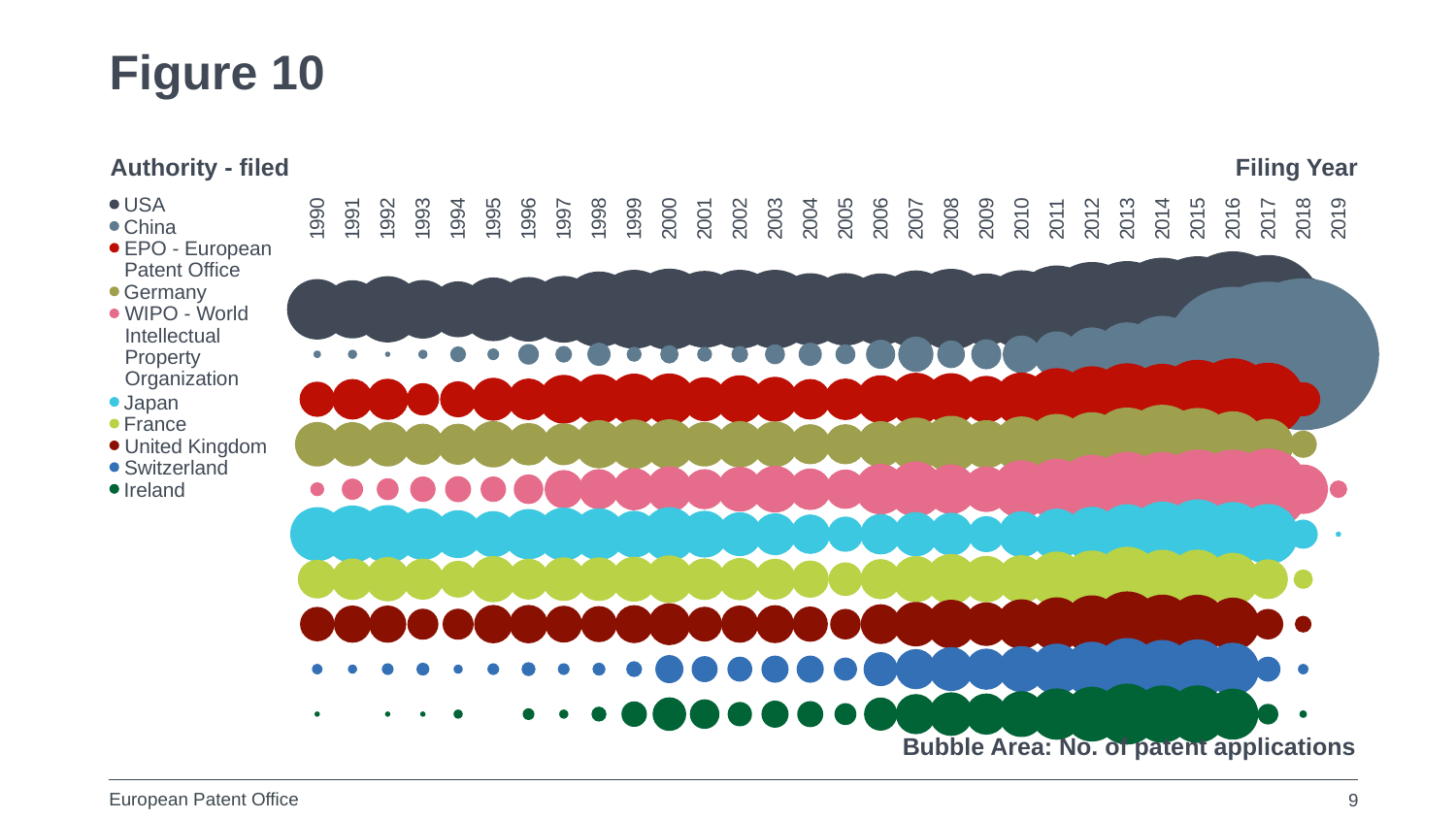
How many authorities does the legend list? 10 Is the China bubble larger in 1990 or in 2019? 2019 What is the label of the x axis? Filing Year Which authority has the largest bubble in 2019? China Does the bubble size for China rise or fall from 1990 to 2019? Rise Which authority has the smallest bubble in 1990? Ireland What is the first filing year shown on the x axis? 1990 What is the last filing year shown on the x axis? 2019 What does the bubble area represent according to the slide? No. of patent applications How many filing years are shown along the x axis? 30 Does the bubble size for Ireland rise or fall from 1990 to 2010? Rise What kind of chart is shown on the slide? Bubble chart